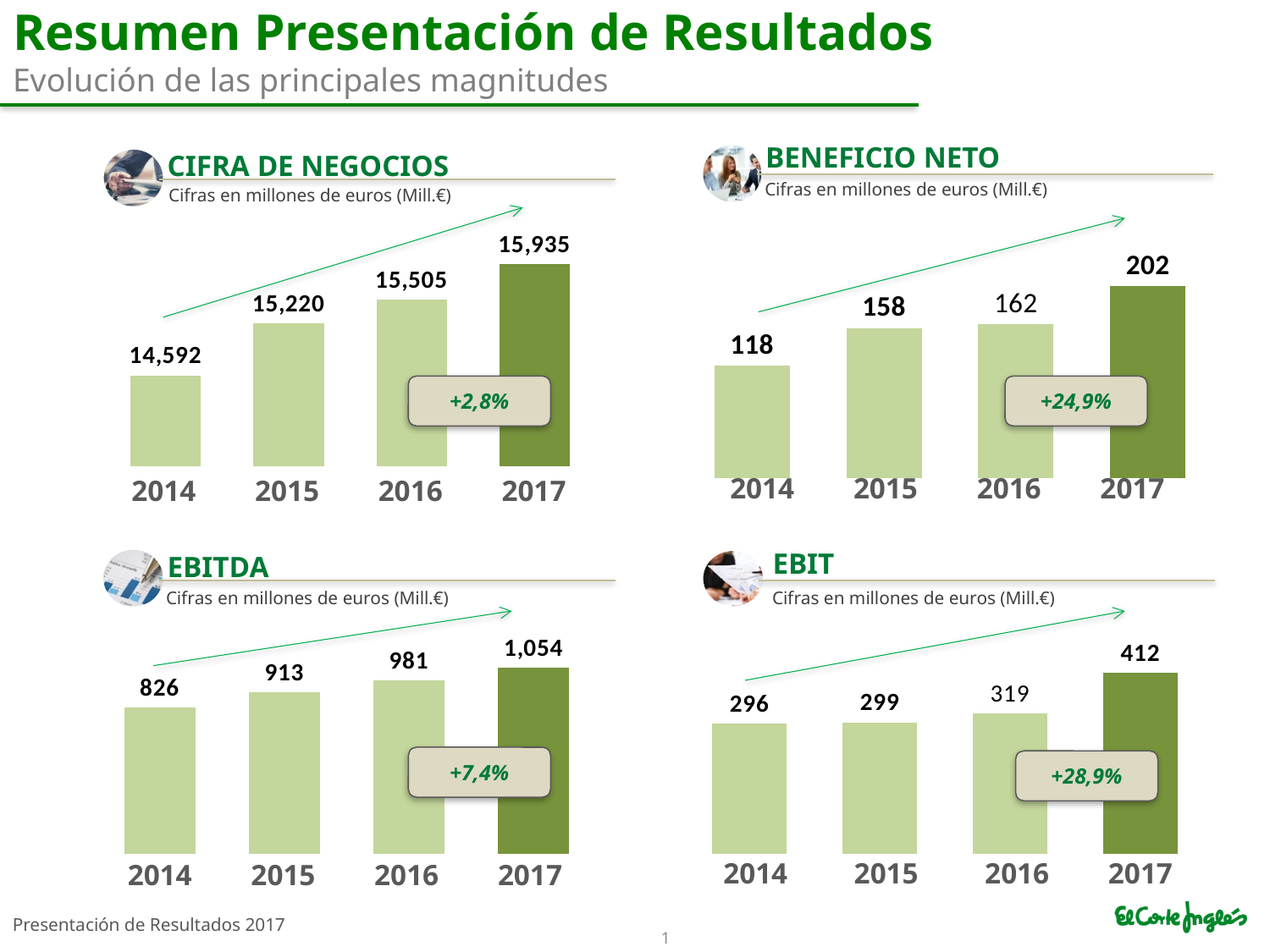
What kind of chart is the BENEFICIO NETO chart? Bar chart In the CIFRA DE NEGOCIOS chart, what is the value for 2017? 15,935 In the EBIT chart, what is the value for 2015? 299 In the BENEFICIO NETO chart, what is the difference between the 2017 and 2016 values? 40 In the EBITDA chart, what is the difference between the 2015 and 2014 values? 87 In the CIFRA DE NEGOCIOS chart, which year has the lowest value? 2014 In the CIFRA DE NEGOCIOS chart, do the values rise or fall from 2014 to 2017? Rise In the BENEFICIO NETO chart, what is the value for 2014? 118 In the EBIT chart, which is larger, the value for 2016 or the value for 2015? 2016 In the EBIT chart, which year has the highest value? 2017 In the EBITDA chart, what is the value for 2016? 981 How many years are shown in the EBITDA chart? 4